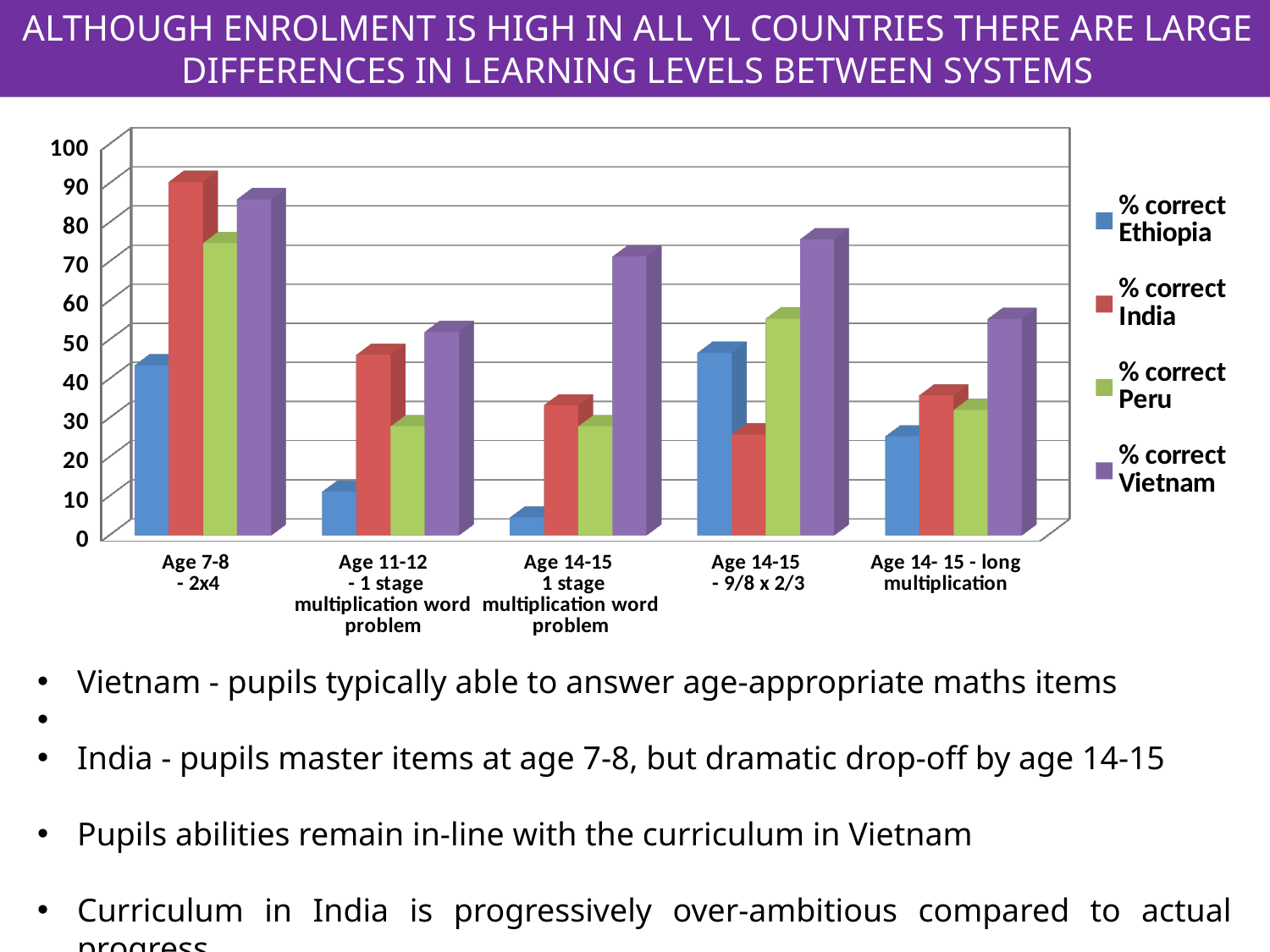
In the 'Age 14-15 - 9/8 x 2/3' category, which is larger: the % correct for Ethiopia or for India? Ethiopia For the category 'Age 14-15 1 stage multiplication word problem', which country has the highest % correct? Vietnam Is the % correct for Ethiopia in the 'Age 7-8 - 2x4' category greater or less than 50? less What kind of chart is shown on the slide? bar chart How many series does the chart legend list? 4 For the category 'Age 14-15 1 stage multiplication word problem', which country has the lowest % correct? Ethiopia For the category 'Age 14-15 - 9/8 x 2/3', which country has the highest % correct? Vietnam What colour represents '% correct Vietnam' in the chart legend? purple For the category 'Age 11-12 - 1 stage multiplication word problem', which country has the lowest % correct? Ethiopia How many categories are shown along the x axis of the chart? 5 In the 'Age 11-12 - 1 stage multiplication word problem' category, which is larger: the % correct for India or for Peru? India Is the % correct for Vietnam in the 'Age 14-15 1 stage multiplication word problem' category greater or less than 60? greater